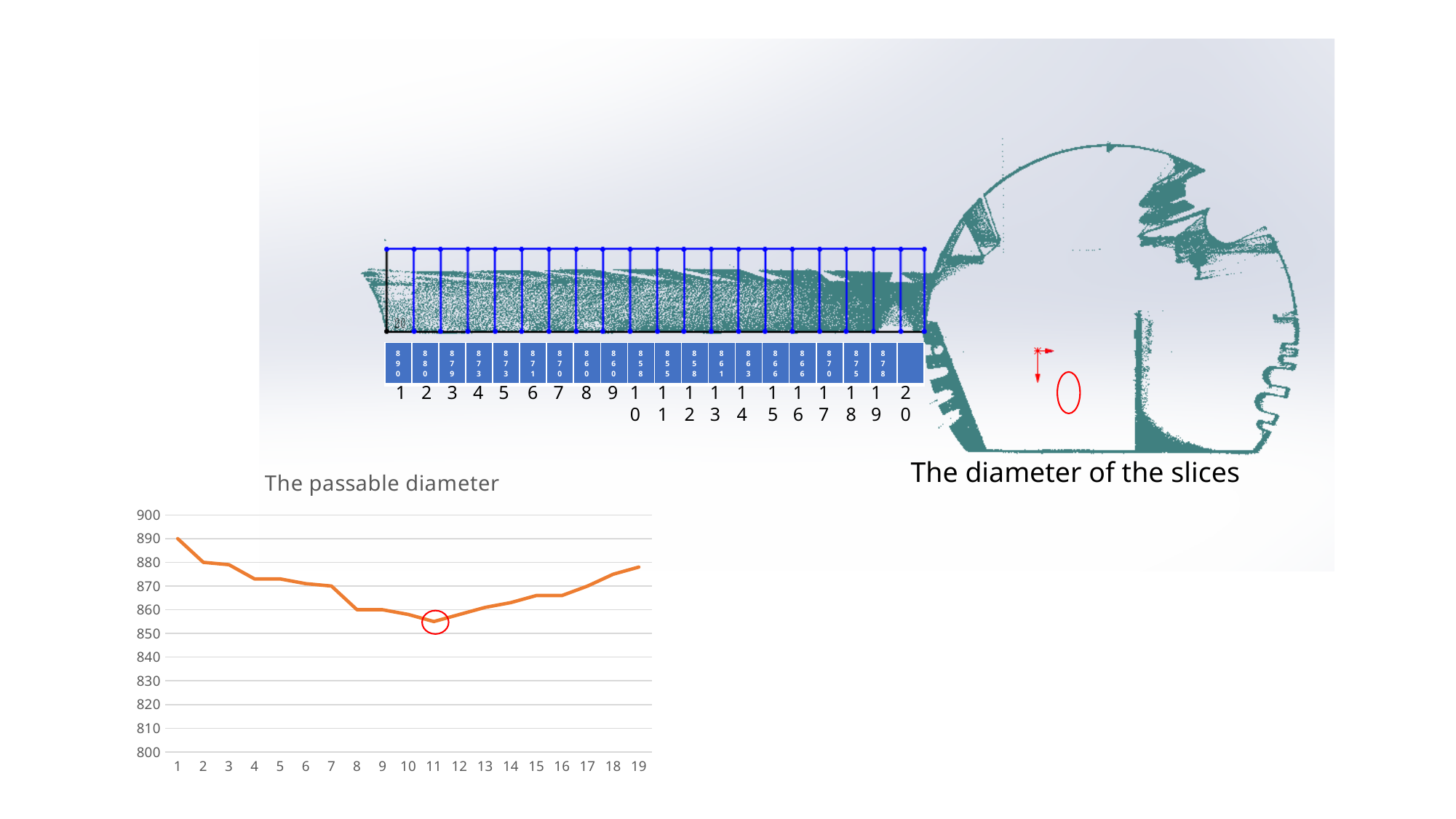
In "The passable diameter" chart, is the value at point 19 greater or less than 870? greater In "The passable diameter" chart, what is the value at point 1? 890 In "The passable diameter" chart, which x-axis point has the highest value? 1 What is the title of the line chart on the slide? The passable diameter How many points are plotted along the x axis of "The passable diameter" chart? 19 What kind of chart is "The passable diameter"? line chart In "The passable diameter" chart, which x-axis point has the lowest value? 11 In "The passable diameter" chart, which is larger, the value at point 3 or the value at point 16? point 3 In "The passable diameter" chart, do the values rise or fall from point 1 to point 11? fall In "The passable diameter" chart, what is the difference between the value at point 1 and the value at point 8? 30 In "The passable diameter" chart, is the value at point 11 greater or less than 860? less In "The passable diameter" chart, what is the value at point 8? 860